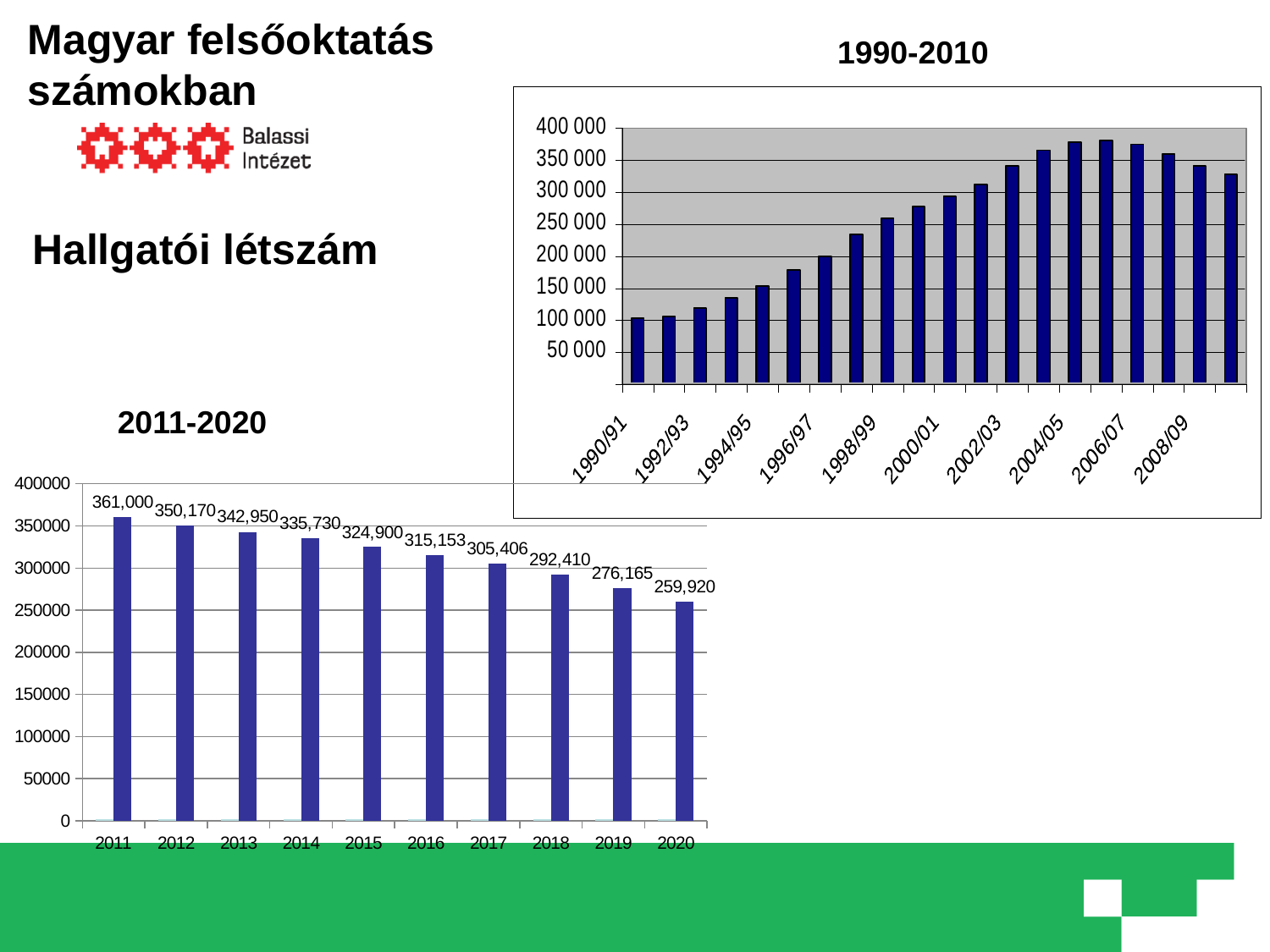
In the 2011-2020 chart, do the values rise or fall from 2011 to 2020? fall In the 2011-2020 chart, which year has the lowest value? 2020 How many years are shown in the 2011-2020 chart? 10 In the 1990-2010 chart, is the value for 1992/93 greater or less than 150 000? less In the 2011-2020 chart, what is the difference between the values for 2011 and 2020? 101,080 In the 1990-2010 chart, is the value for 2006/07 greater or less than 350 000? greater In the 2011-2020 chart, what is the value for 2011? 361,000 In the 2011-2020 chart, what is the value for 2020? 259,920 In the 2011-2020 chart, which year has the highest value? 2011 What kind of chart is the 1990-2010 chart? bar chart In the 2011-2020 chart, what is the difference between the values for 2018 and 2019? 16,245 In the 2011-2020 chart, what is the value for 2016? 315,153